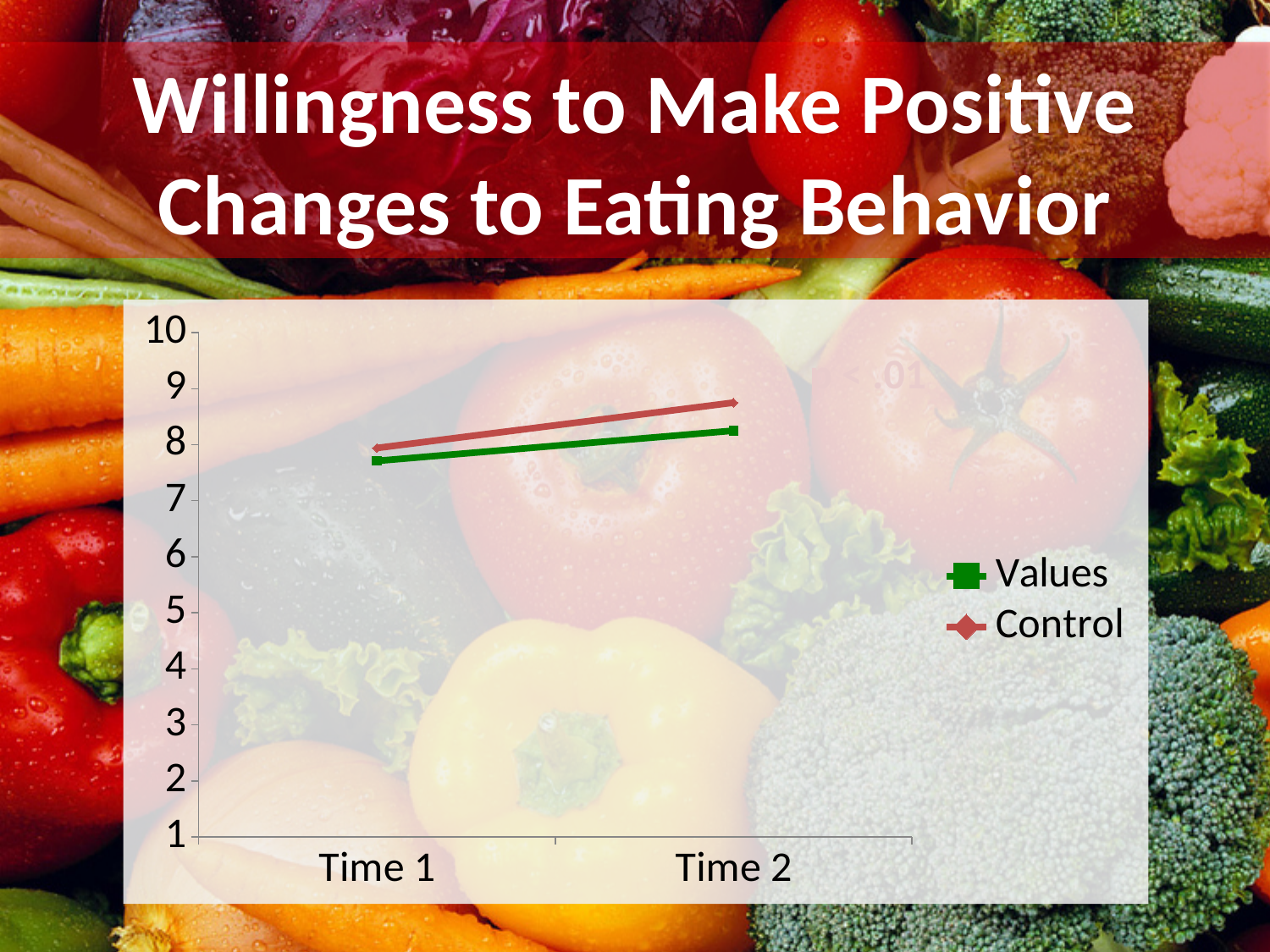
What kind of chart is shown on the slide? line chart Is the value for Control at Time 2 greater or less than 8? greater Does the Values line rise or fall from Time 1 to Time 2? rise Does the Control line rise or fall from Time 1 to Time 2? rise How many time points are shown on the x axis? 2 Which series is drawn in green? Values Is the value for Values at Time 1 greater or less than 7? greater At Time 2, which series has the higher value, Values or Control? Control Is the value for Values at Time 1 greater or less than 8? less How many series does the legend list? 2 What is the title of the slide containing the chart? Willingness to Make Positive Changes to Eating Behavior